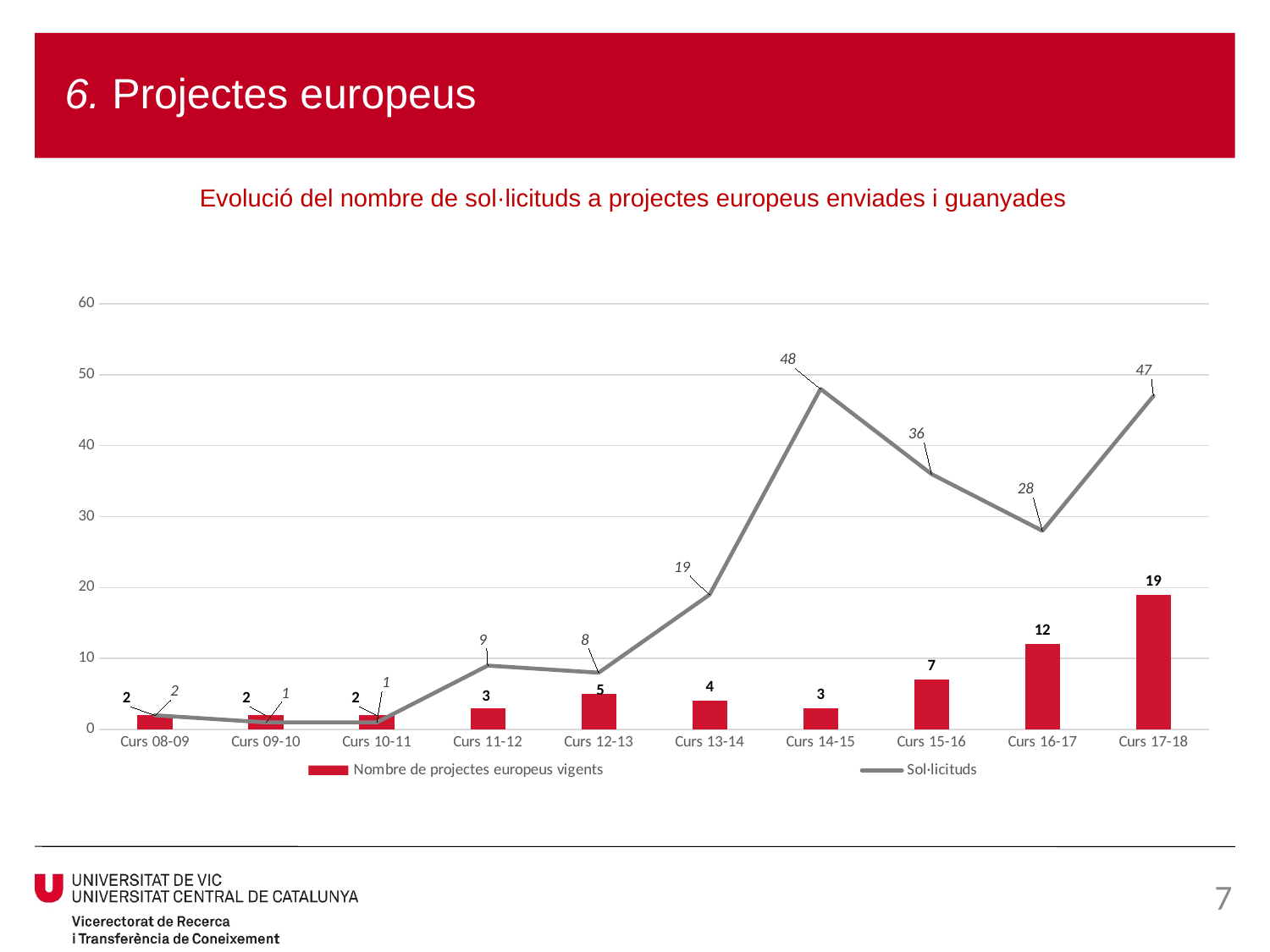
How many Curs categories are shown on the x axis? 10 Which Curs has the highest value of Sol·licituds? Curs 14-15 How many series does the legend list? 2 Does the Nombre de projectes europeus vigents series rise or fall from Curs 14-15 to Curs 17-18? rise What is the value of Sol·licituds for Curs 14-15? 48 What is the difference between Nombre de projectes europeus vigents for Curs 17-18 and Curs 16-17? 7 What is the value of Nombre de projectes europeus vigents for Curs 16-17? 12 Which series is drawn as a line? Sol·licituds What is the difference between Sol·licituds for Curs 14-15 and Curs 15-16? 12 Which Curs has the highest value of Nombre de projectes europeus vigents? Curs 17-18 What is the value of Sol·licituds for Curs 11-12? 9 Which is larger: Sol·licituds for Curs 16-17 or Sol·licituds for Curs 13-14? Curs 16-17